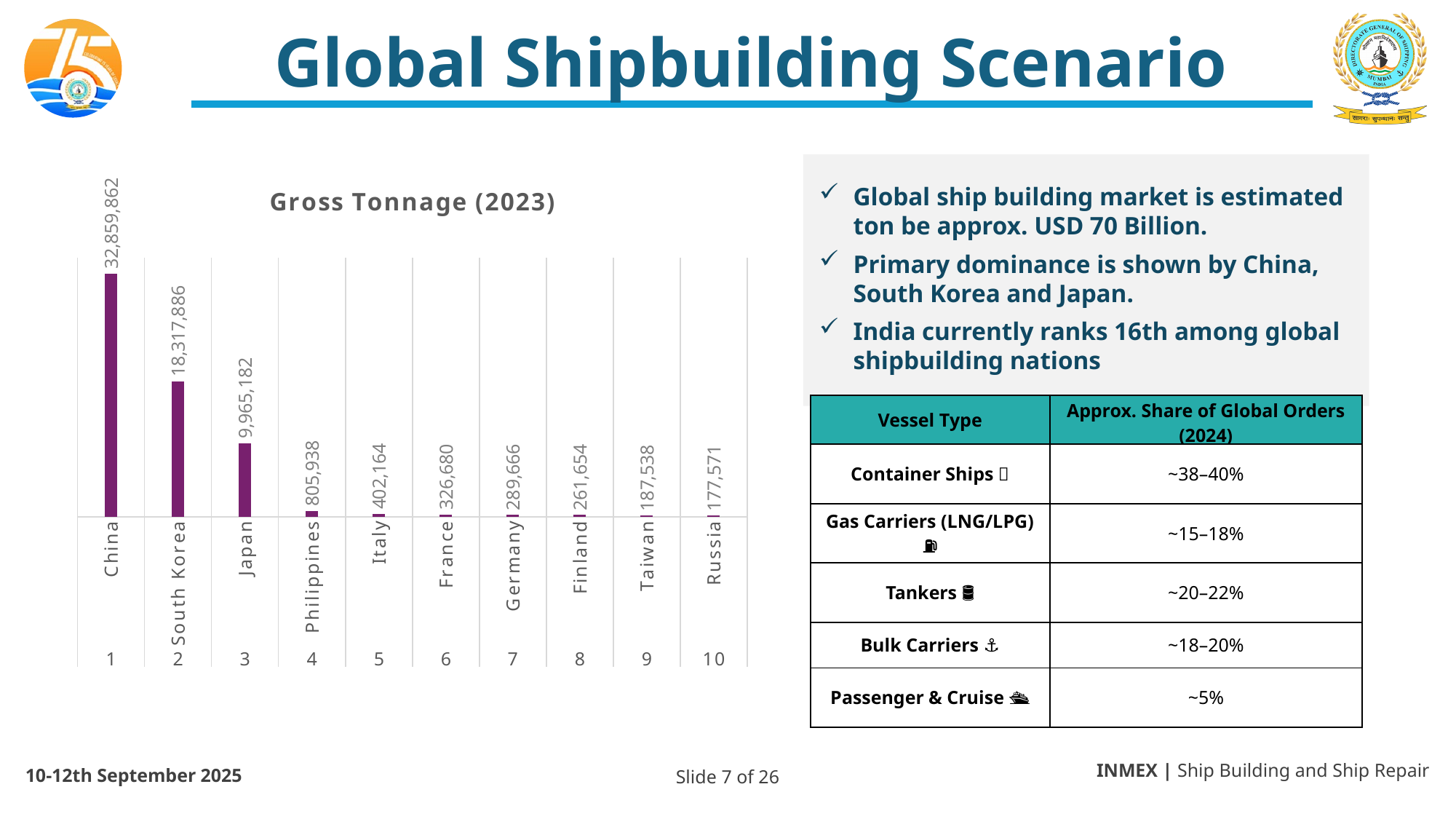
What is the gross tonnage shown for China in the Gross Tonnage (2023) chart? 32,859,862 Which country has the lowest gross tonnage in the chart? Russia What kind of chart is used to show Gross Tonnage (2023)? Bar chart How many countries are shown in the Gross Tonnage (2023) chart? 10 What value is shown for the Philippines in the Gross Tonnage (2023) chart? 805,938 Which has a larger gross tonnage, Italy or France? Italy Do the gross tonnage values rise or fall from left to right across the chart? Fall What is the difference in gross tonnage between China and South Korea? 14,541,976 Which country has the highest gross tonnage in the chart? China What is the gross tonnage shown for Japan? 9,965,182 What is the difference in gross tonnage between South Korea and Japan? 8,352,704 What is the gross tonnage value for Russia? 177,571